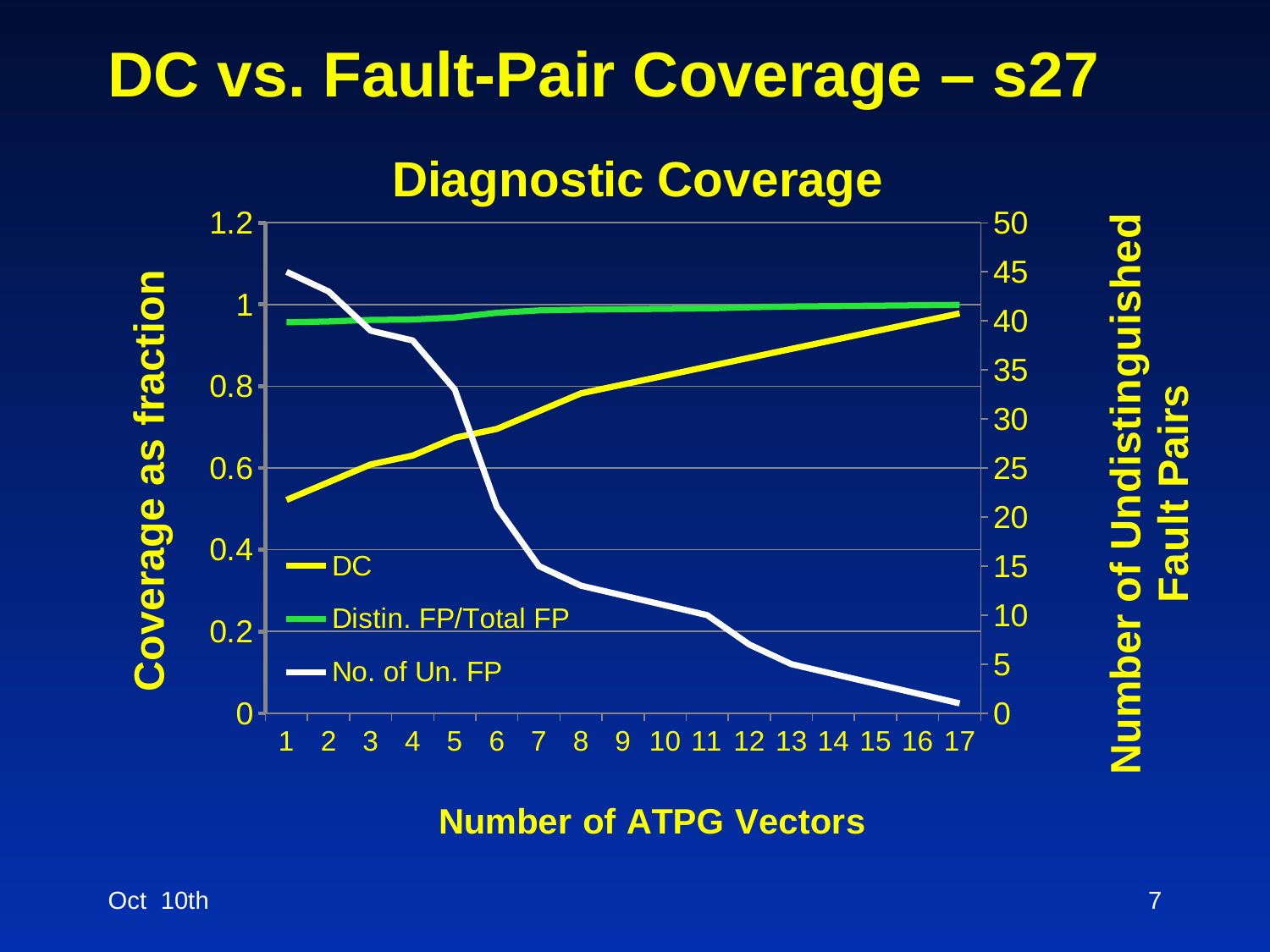
How many ATPG vector values are plotted along the x axis? 17 What is the title of the chart? Diagnostic Coverage What kind of chart is shown on the slide? line chart Is the No. of Un. FP value at 17 ATPG vectors greater or less than 5? less At 1 ATPG vector, which is higher on the left axis: DC or Distin. FP/Total FP? Distin. FP/Total FP How many series does the legend list? 3 Is the DC value at 1 ATPG vector greater or less than 0.6? less Is the No. of Un. FP value at 1 ATPG vector greater or less than 40? greater Does the No. of Un. FP series rise or fall as the number of ATPG vectors increases? falls What is the title of the right-hand vertical axis? Number of Undistinguished Fault Pairs Does the DC series rise or fall as the number of ATPG vectors increases? rises